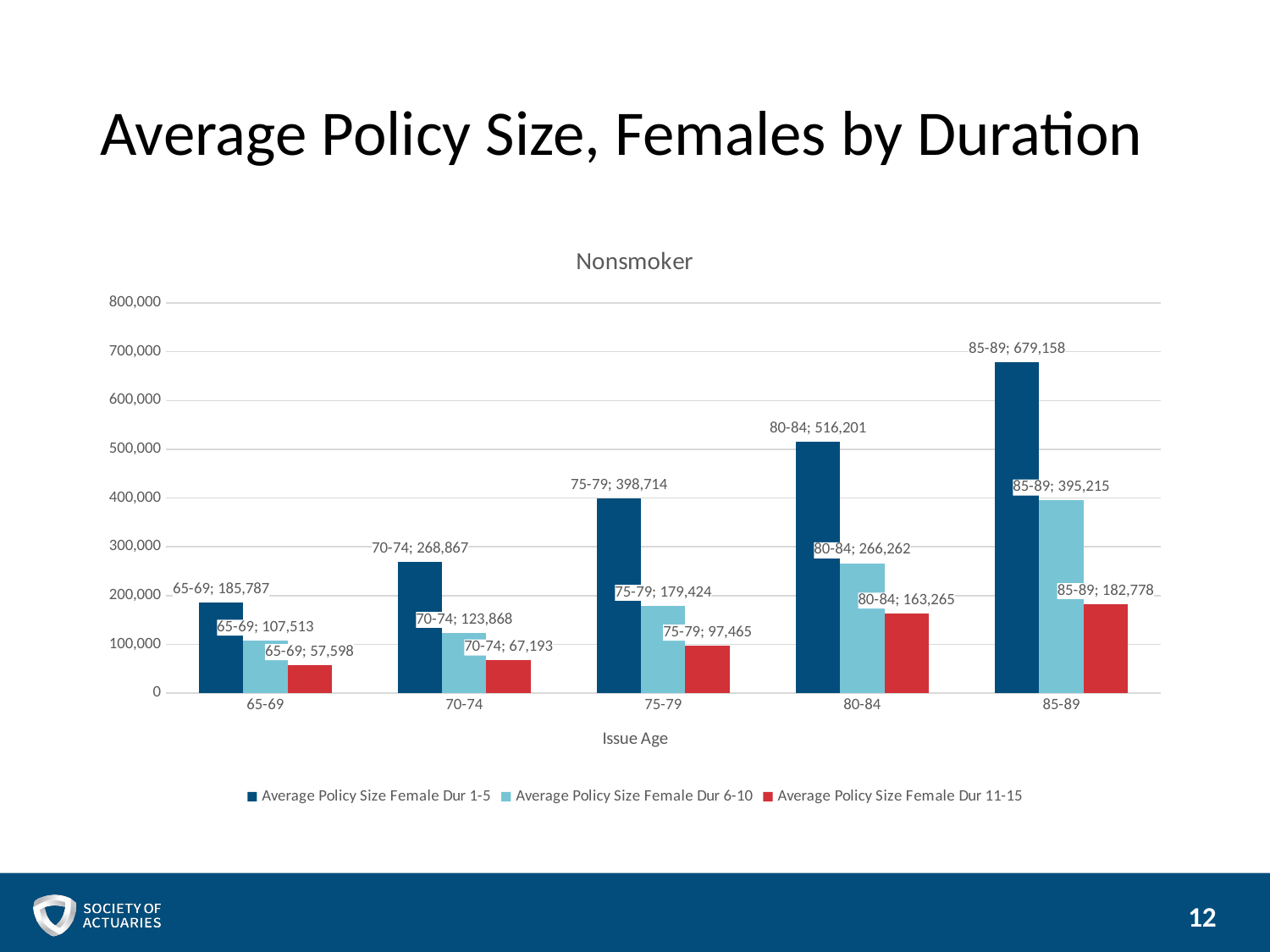
Do the Average Policy Size Female Dur 1-5 values rise or fall as issue age increases? rise How many series does the legend list? 3 What is the Average Policy Size Female Dur 6-10 value for issue age 75-79? 179,424 What is the Average Policy Size Female Dur 1-5 value for issue age 85-89? 679,158 What is the difference between the Dur 1-5 and Dur 6-10 values for issue age 85-89? 283,943 What is the Average Policy Size Female Dur 11-15 value for issue age 65-69? 57,598 How many issue age categories are shown on the x axis? 5 Which issue age has the lowest Average Policy Size Female Dur 11-15 value? 65-69 Which is larger for issue age 80-84: the Dur 6-10 value or the Dur 11-15 value? Dur 6-10 Which issue age has the highest Average Policy Size Female Dur 1-5 value? 85-89 Is the Average Policy Size Female Dur 1-5 value for issue age 80-84 greater or less than 500,000? greater What kind of chart is shown on the slide? bar chart